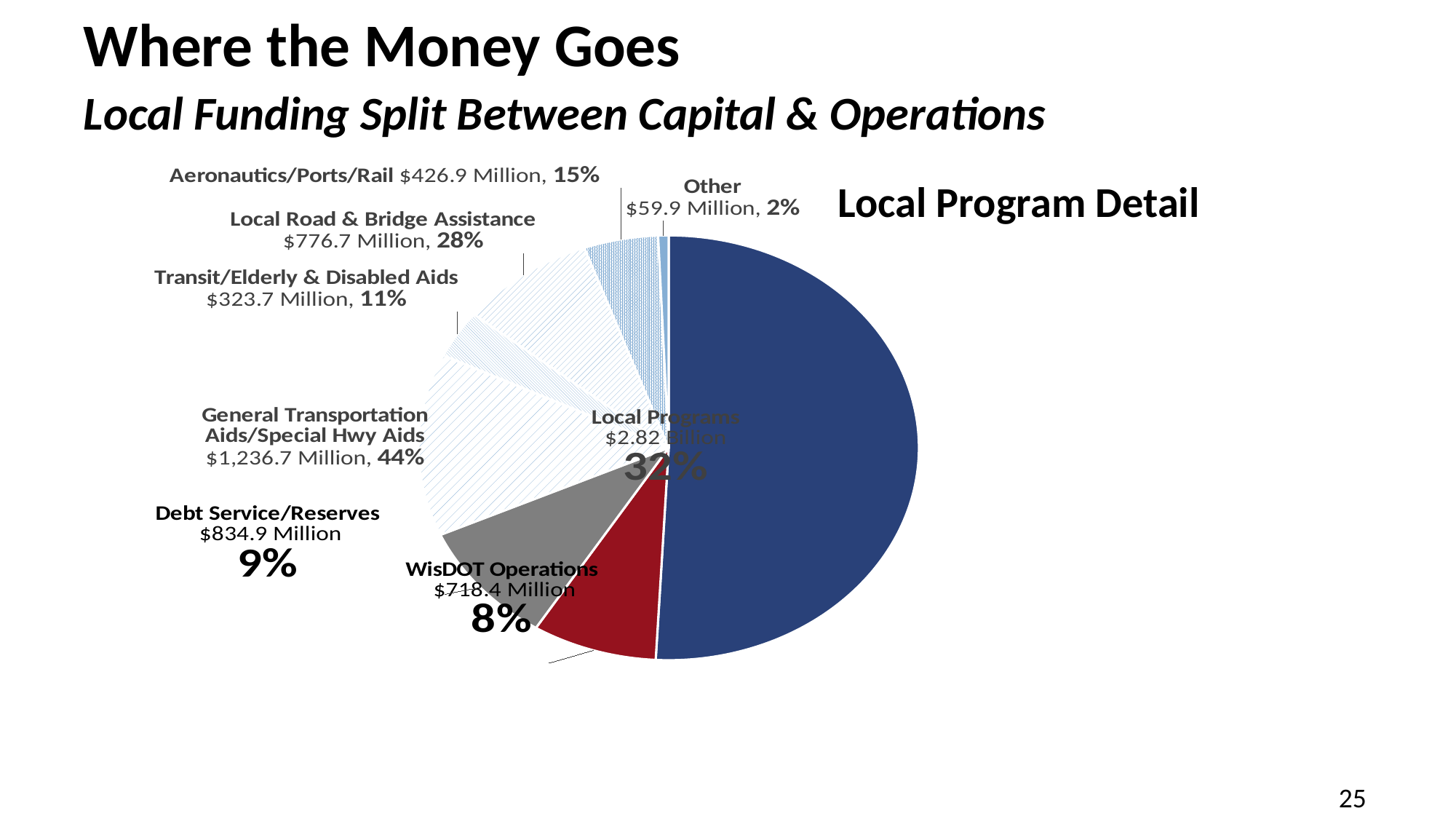
What percentage is shown for Transit/Elderly & Disabled Aids? 11% How many Local Program Detail categories are labeled on the chart? 5 Which is larger, the dollar amount for Debt Service/Reserves or for WisDOT Operations? Debt Service/Reserves Which Local Program Detail category has the smallest share? Other What is the dollar amount shown for Local Programs? $2.82 Billion What kind of chart is shown on the slide? Pie chart What percentage is shown for WisDOT Operations? 8% What is the dollar amount shown for Aeronautics/Ports/Rail? $426.9 Million Which Local Program Detail category has the largest share? General Transportation Aids/Special Hwy Aids What is the dollar amount shown for Local Road & Bridge Assistance? $776.7 Million What percentage is shown for General Transportation Aids/Special Hwy Aids? 44% What is the difference in percentage points between General Transportation Aids/Special Hwy Aids and Local Road & Bridge Assistance? 16%